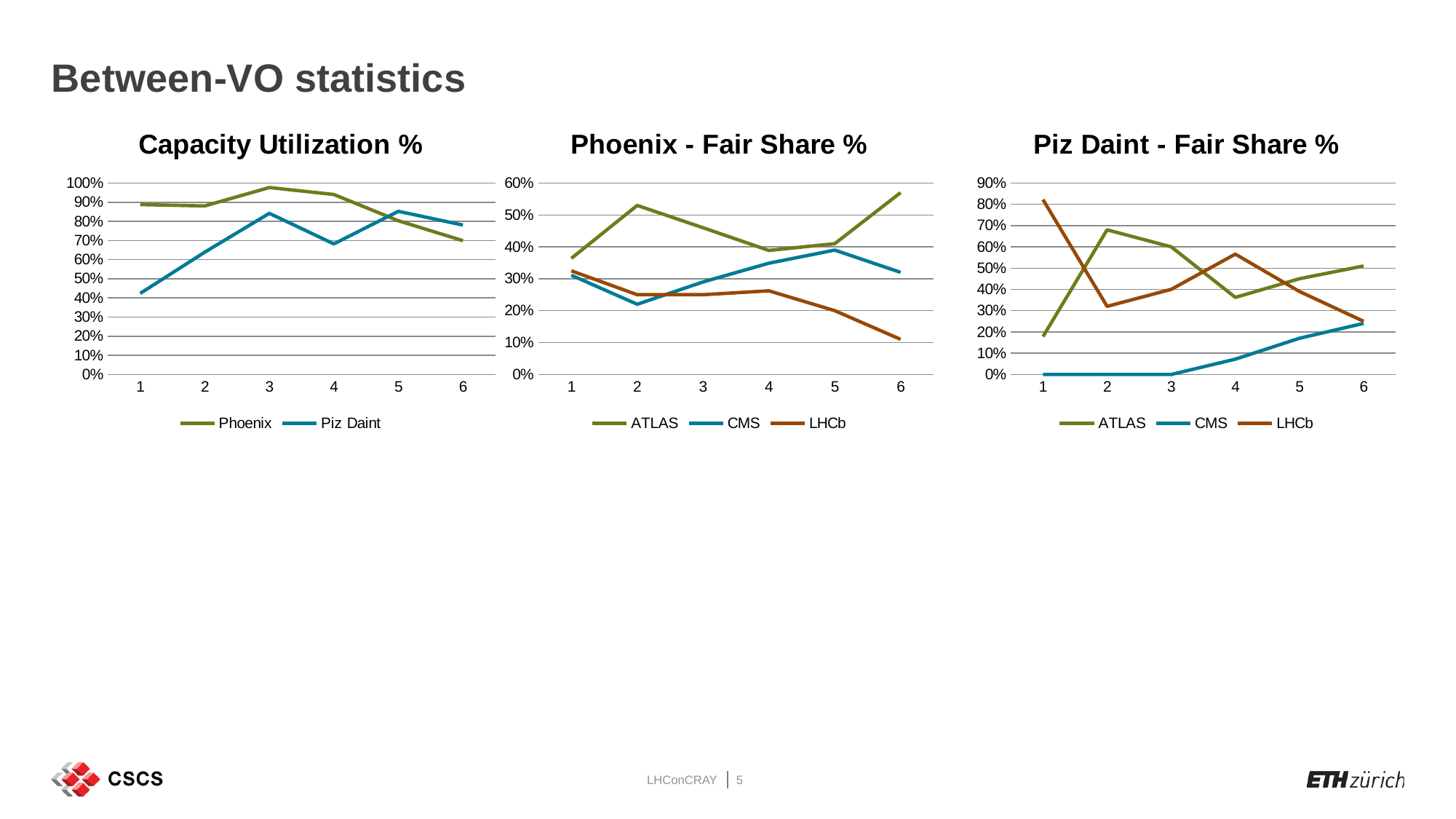
In the Capacity Utilization % chart, is the value for Phoenix at point 3 greater or less than 90%? greater In the Phoenix - Fair Share % chart, at which x-axis point is LHCb lowest? 6 In the Phoenix - Fair Share % chart, is the value for ATLAS at point 6 greater or less than 50%? greater In the Piz Daint - Fair Share % chart, does the CMS series rise or fall from point 3 to point 6? rise In the Capacity Utilization % chart, which series is higher at point 6, Phoenix or Piz Daint? Piz Daint In the Capacity Utilization % chart, is the value for Piz Daint at point 1 greater or less than 50%? less In the Phoenix - Fair Share % chart, which series is higher at point 2, ATLAS or CMS? ATLAS In the Capacity Utilization % chart, at which x-axis point does Phoenix reach its highest value? 3 What kind of chart is the Piz Daint - Fair Share % chart? line chart In the Piz Daint - Fair Share % chart, what is the value for CMS at point 1? 0% In the Phoenix - Fair Share % chart, how many series does the legend list? 3 In the Capacity Utilization % chart, at which x-axis point is Piz Daint lowest? 1